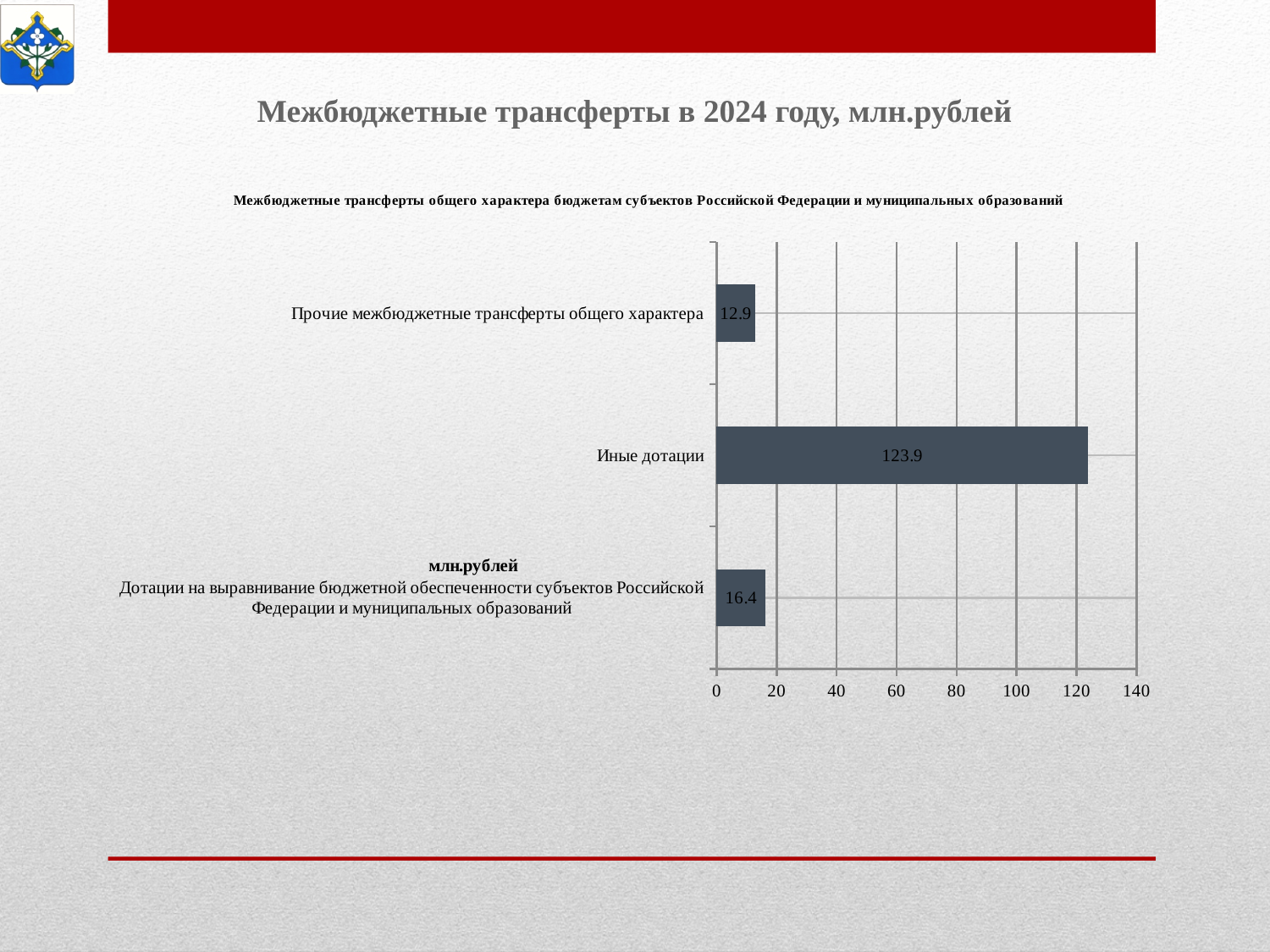
Which category has the lowest value? Прочие межбюджетные трансферты общего характера What is the value for Прочие межбюджетные трансферты общего характера? 12.9 Is the value for Иные дотации greater or less than 100? greater Which category has the highest value? Иные дотации What is the value for Дотации на выравнивание бюджетной обеспеченности субъектов Российской Федерации и муниципальных образований? 16.4 What is the difference between the values for Дотации на выравнивание бюджетной обеспеченности and Прочие межбюджетные трансферты общего характера? 3.5 What is the value for Иные дотации? 123.9 How many categories are shown in the chart? 3 What kind of chart is shown on the slide? bar chart What is the difference between the values for Иные дотации and Дотации на выравнивание бюджетной обеспеченности? 107.5 Which is larger: the value for Дотации на выравнивание бюджетной обеспеченности or the value for Прочие межбюджетные трансферты общего характера? Дотации на выравнивание бюджетной обеспеченности What is the title of the chart? Межбюджетные трансферты общего характера бюджетам субъектов Российской Федерации и муниципальных образований